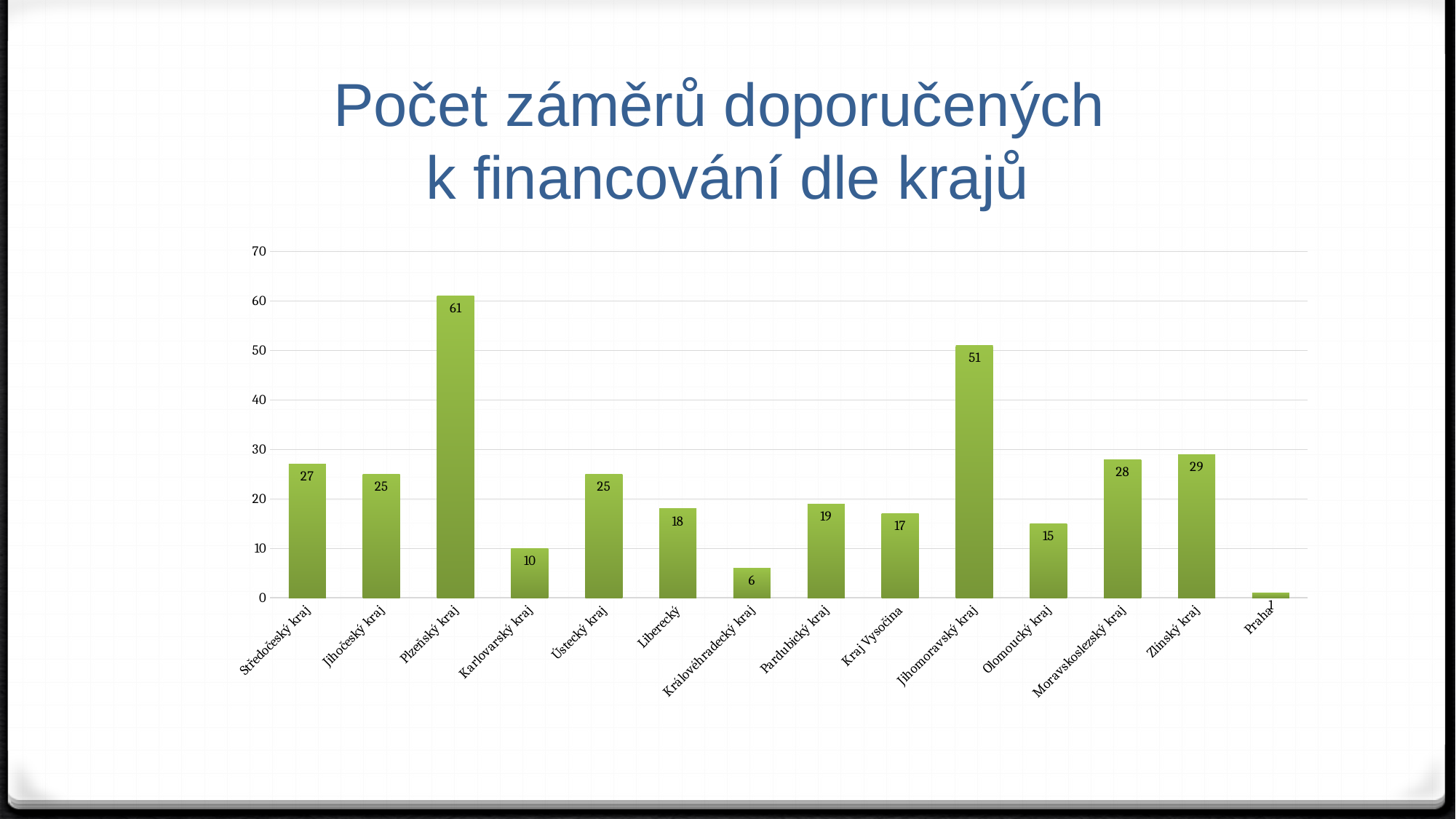
What is the value for Jihomoravský kraj? 51 What is the value for Moravskoslezský kraj? 28 What is the value for Královéhradecký kraj? 6 What is the difference between the values for Plzeňský kraj and Jihomoravský kraj? 10 Is the value for Karlovarský kraj greater or less than 20? less Which is larger, the value for Zlínský kraj or the value for Olomoucký kraj? Zlínský kraj What is the value for Plzeňský kraj? 61 What type of chart is shown on the slide? bar chart What is the title of the chart? Počet záměrů doporučených k financování dle krajů Which region has the lowest value? Praha How many regions are shown on the x axis? 14 Which region has the highest value? Plzeňský kraj